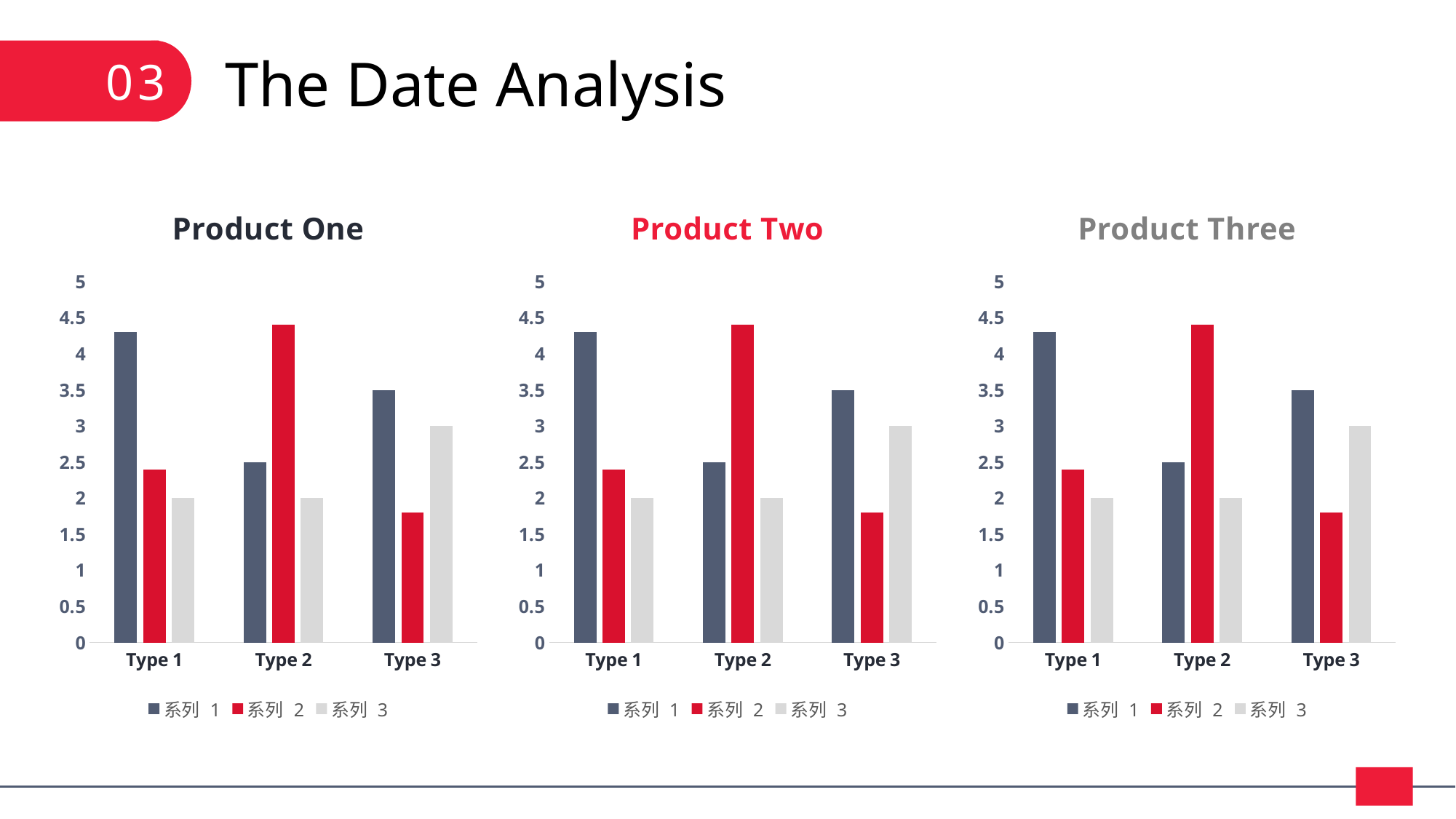
What colour are the 系列 2 bars in the Product Three chart? red In the Product Three chart, which is larger for Type 2: 系列 1 or 系列 2? 系列 2 In the Product Two chart, what is the 系列 3 value for Type 3? 3 In the Product One chart, is the 系列 2 value for Type 3 greater or less than 2? less What kind of chart is the Product One chart? bar chart In the Product Three chart, is the 系列 1 value for Type 1 greater or less than 4? greater How many series does the legend of the Product Two chart list? 3 How many categories are shown on the x axis of the Product Three chart? 3 In the Product Two chart, which category has the lowest 系列 2 bar? Type 3 In the Product One chart, which category has the highest 系列 1 bar? Type 1 In the Product Two chart, is the 系列 2 value for Type 2 greater or less than 4? greater In the Product One chart, which is larger for Type 3: 系列 1 or 系列 3? 系列 1